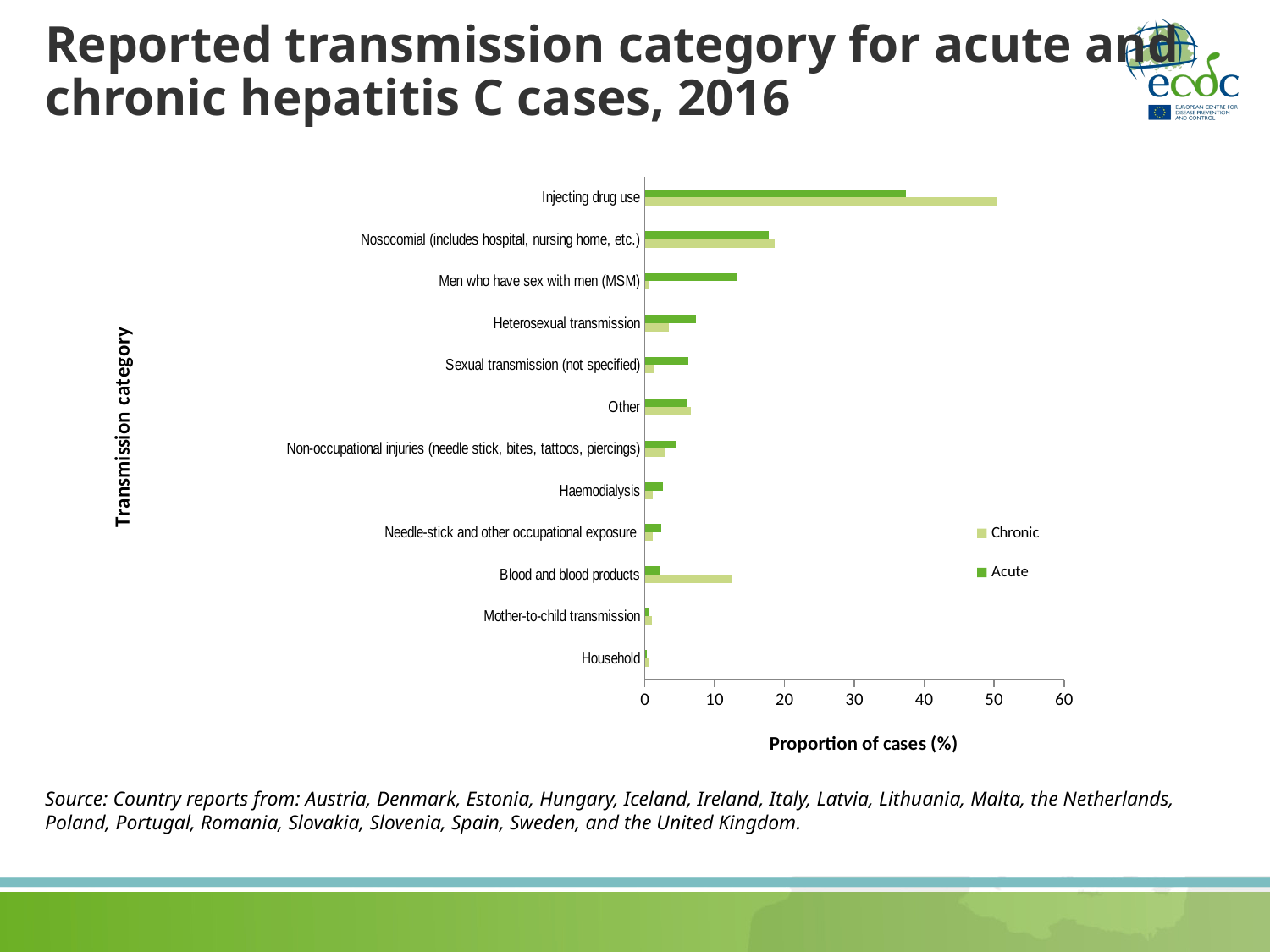
What is the title of the horizontal axis? Proportion of cases (%) Is the Chronic value for Injecting drug use greater or less than 40? greater What kind of chart is shown on the slide? bar chart For Men who have sex with men (MSM), which series has the larger value, Acute or Chronic? Acute How many transmission categories are listed on the chart? 12 Is the Chronic value for Blood and blood products greater or less than 10? greater How many series does the legend list? 2 Is the Acute value for Men who have sex with men (MSM) greater or less than 10? greater Which transmission category has the highest proportion of Acute cases? Injecting drug use Which transmission category has the highest proportion of Chronic cases? Injecting drug use For Blood and blood products, which series has the larger value, Acute or Chronic? Chronic